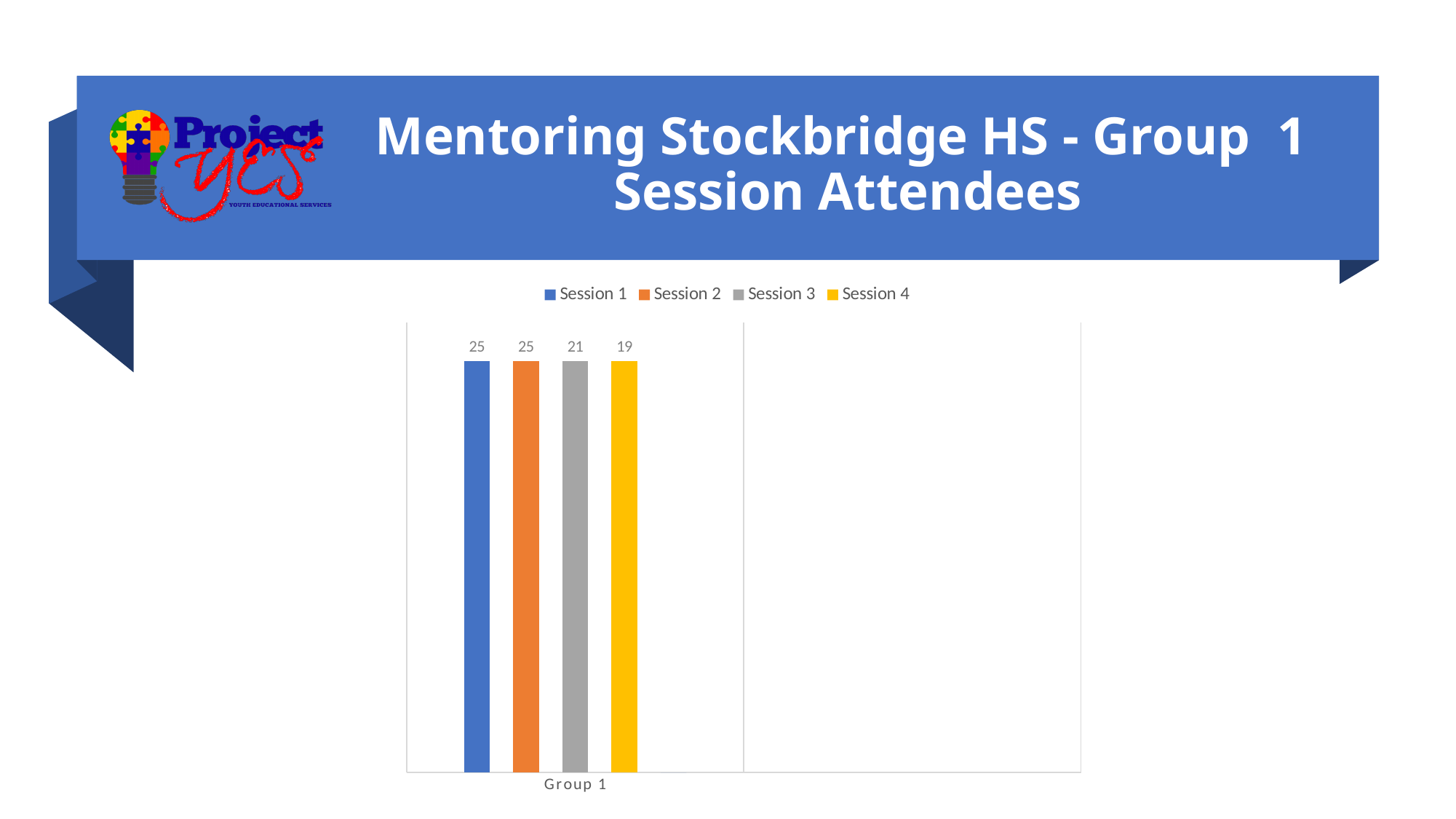
What is the value for Session 3 in Group 1? 21 What is the difference between the Session 2 value and the Session 3 value? 4 What is the value for Session 2 in Group 1? 25 Which session has the lowest number of attendees? Session 4 What is the difference between the Session 1 value and the Session 4 value? 6 How many series does the legend list? 4 What is the value for Session 4 in Group 1? 19 What is the value for Session 1 in Group 1? 25 Which is larger, the value for Session 3 or the value for Session 4? Session 3 What is the difference between the Session 3 value and the Session 4 value? 2 What kind of chart is shown on the slide? Bar chart How many categories are shown on the x axis? 1